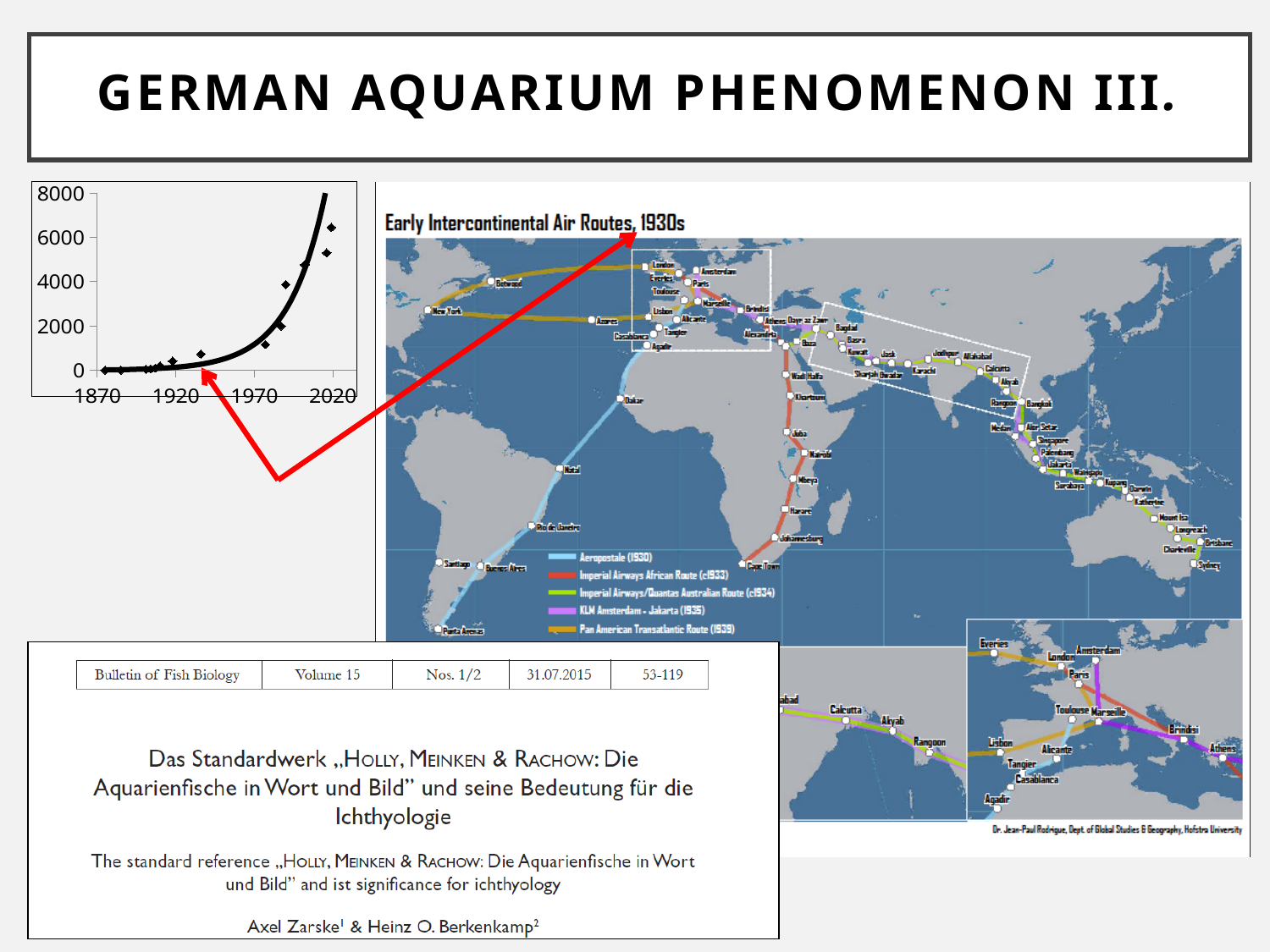
What kind of chart is shown in the top-left of the slide? scatter chart In the top-left chart, which is larger: the earliest plotted value or the latest plotted value? the latest plotted value In the top-left chart, do the plotted values rise or fall as the years increase along the x axis? rise In the top-left chart, does the fitted curve at 2020 reach a value greater or less than 6000? greater In the top-left chart, is the highest plotted point greater or less than 4000? greater In the top-left chart, is the plotted value around 1970 greater or less than 2000? less What is the highest value labelled on the y axis of the top-left chart? 8000 What is the first year labelled on the x axis of the top-left chart? 1870 How many year labels are shown on the x axis of the top-left chart? 4